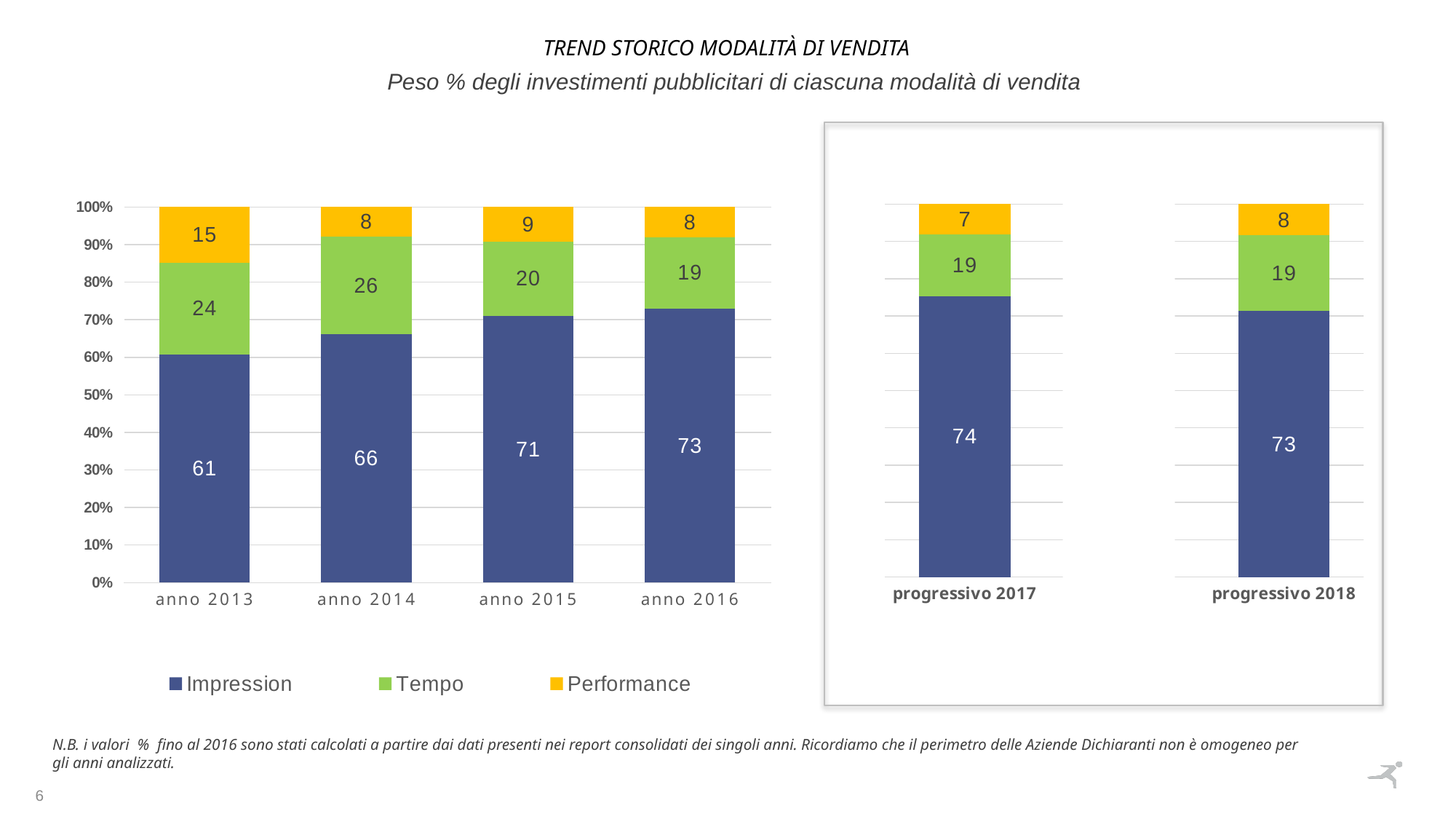
How many series does the legend list? 3 In the left chart (anno 2013–2016), which year has the lowest Impression value? anno 2013 What kind of chart is the left chart (anno 2013–2016)? Stacked bar chart In the left chart (anno 2013–2016), which year has the highest Performance value? anno 2013 In the left chart (anno 2013–2016), what is the difference between the Impression values for anno 2016 and anno 2013? 12 In the right chart (progressivo 2017–2018), what is the Tempo value for progressivo 2018? 19 In the left chart (anno 2013–2016), does the Impression value rise or fall from anno 2013 to anno 2016? Rise In the left chart (anno 2013–2016), how many years are shown on the x axis? 4 In the left chart (anno 2013–2016), what is the Performance value for anno 2015? 9 In the left chart (anno 2013–2016), is the Tempo value larger for anno 2014 or anno 2015? anno 2014 In the right chart (progressivo 2017–2018), what is the Impression value for progressivo 2017? 74 In the left chart (anno 2013–2016), what is the Impression value for anno 2013? 61